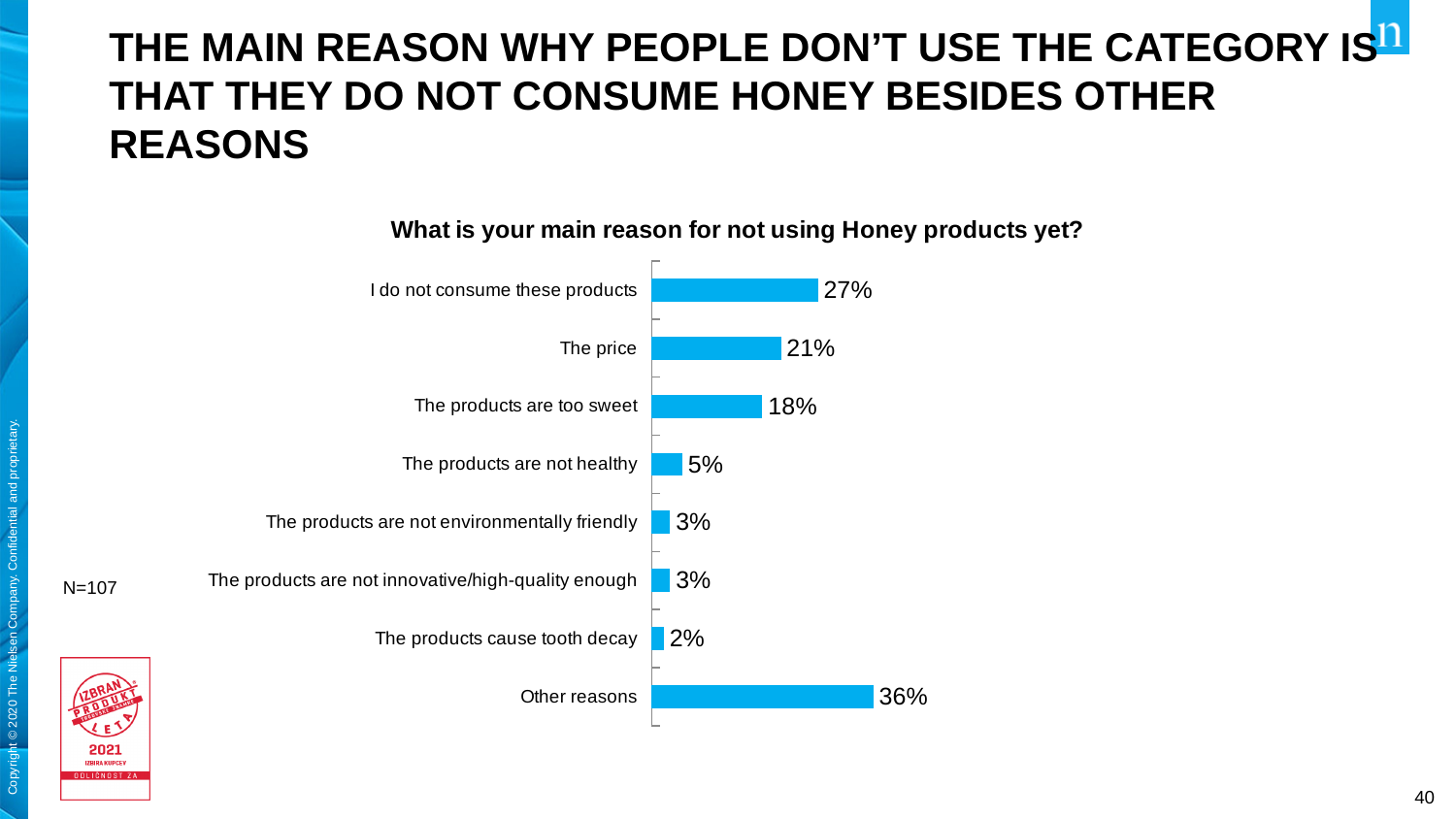
What is the title of the chart? What is your main reason for not using Honey products yet? What is the sample size (N) shown next to the chart? N=107 Which category has the highest value in the chart? Other reasons Which category has the lowest value in the chart? The products cause tooth decay What kind of chart is shown on the slide? Bar chart How many categories are shown in the chart? 8 What is the value for "I do not consume these products"? 27% What is the difference between "Other reasons" and "I do not consume these products"? 9% What percentage is shown for "The products cause tooth decay"? 2% Which is larger: the value for "The products are too sweet" or the value for "The products are not healthy"? The products are too sweet What percentage of respondents gave "The price" as their main reason for not using Honey products? 21% What is the difference between "The price" and "The products are too sweet"? 3%